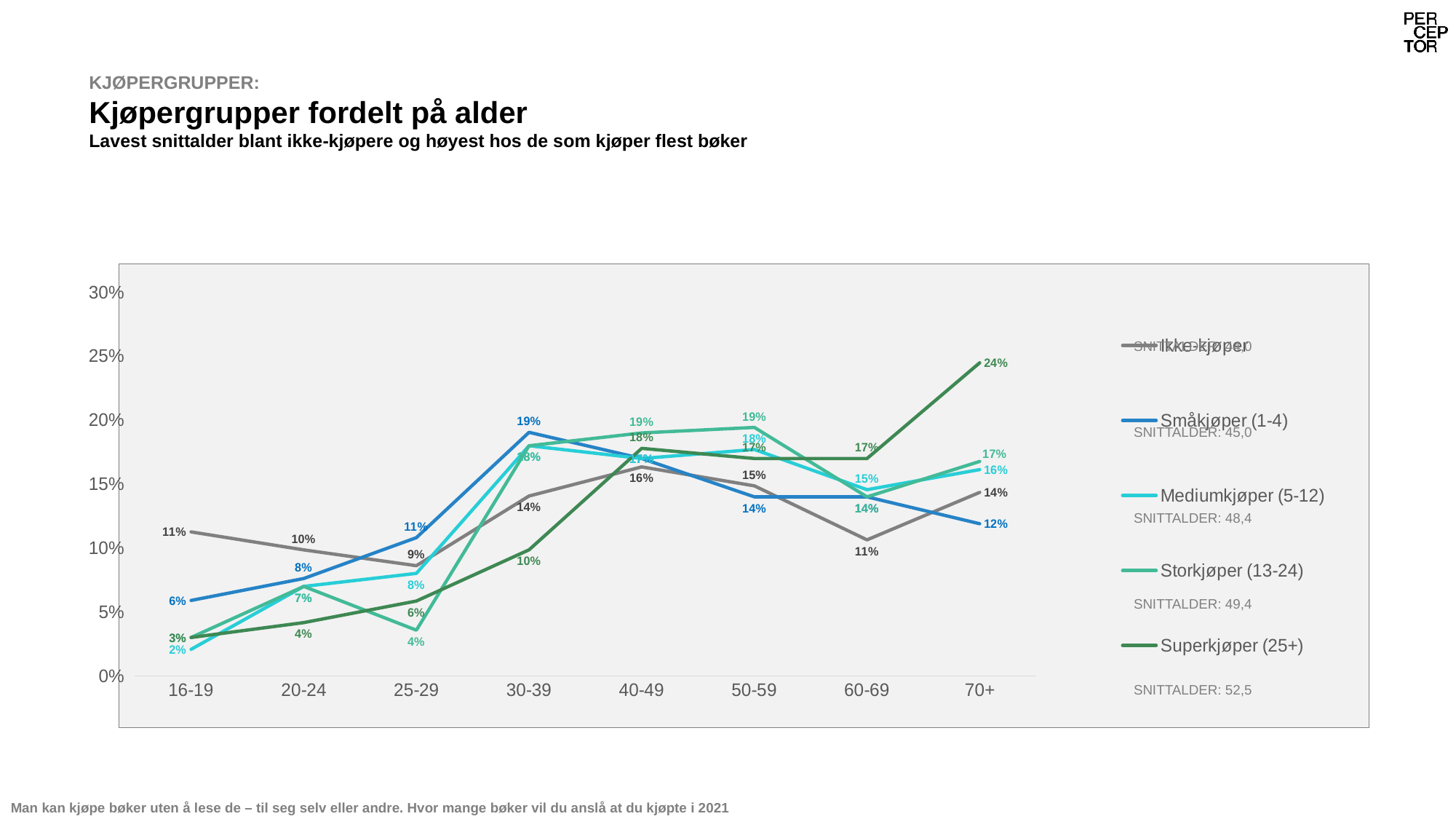
What is the snittalder (average age) shown for Superkjøper (25+)? 52,5 What is the value for Superkjøper (25+) in the 70+ age group? 24% How many age groups are shown on the x axis? 8 How many series does the legend list? 5 In which age group does Ikke-kjøper have its lowest value? 25-29 What kind of chart is shown on the slide? line chart What is the value for Småkjøper (1-4) in the 30-39 age group? 19% What is the value for Mediumkjøper (5-12) in the 16-19 age group? 2% In the 30-39 age group, which is larger: Småkjøper (1-4) or Superkjøper (25+)? Småkjøper (1-4) What is the difference between Superkjøper (25+) and Småkjøper (1-4) in the 70+ age group? 12 percentage points What is the value for Ikke-kjøper in the 16-19 age group? 11% In which age group does Superkjøper (25+) reach its highest value? 70+